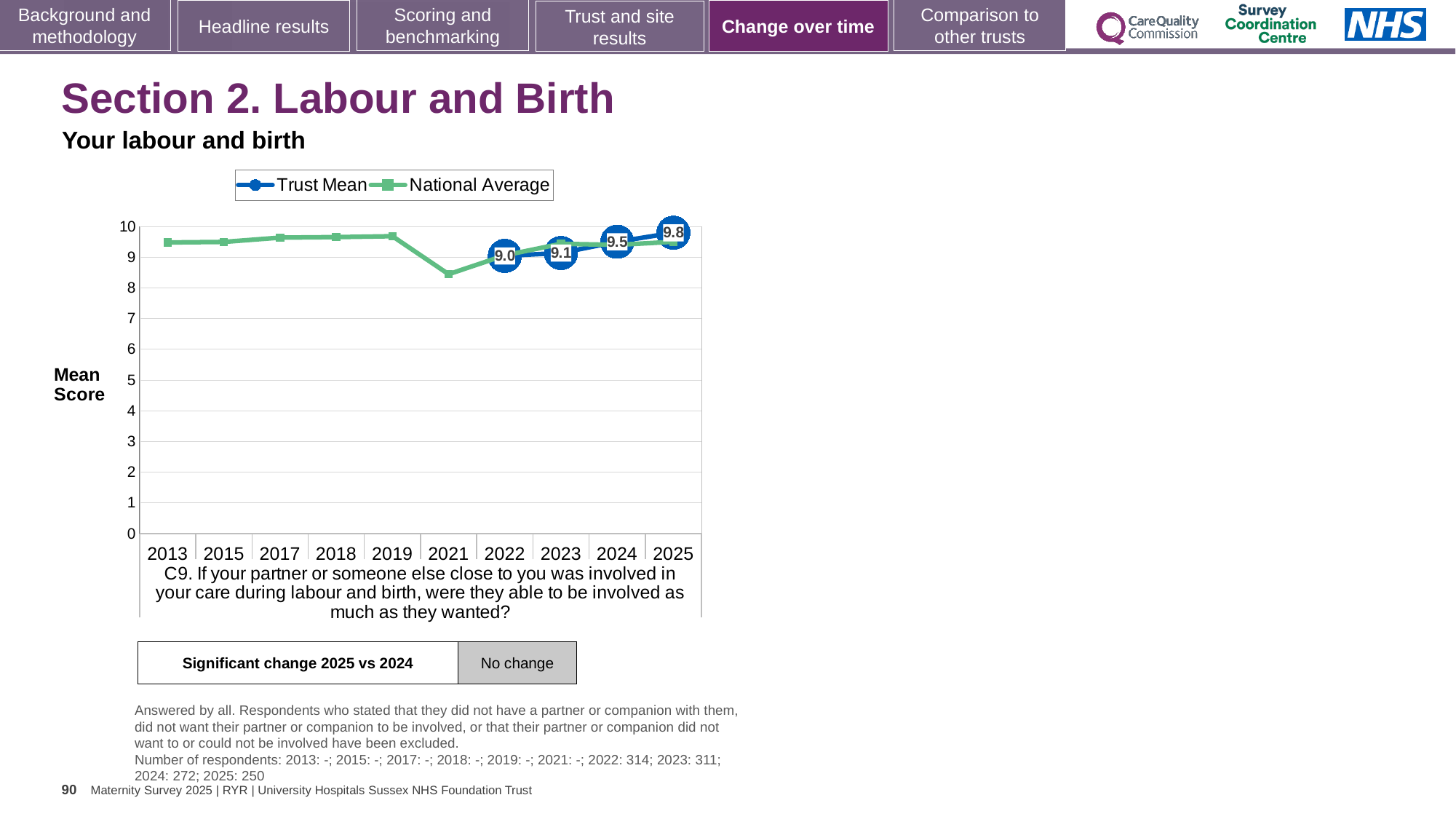
What kind of chart is shown on the slide? Line chart Does the Trust Mean score rise or fall from 2022 to 2025? Rise Is the National Average value for 2021 greater or less than 9? less What is the Trust Mean score for 2023? 9.1 What is the Trust Mean score for 2025? 9.8 How many series does the legend list? 2 In which year is the Trust Mean score lowest? 2022 What is the difference between the Trust Mean scores for 2025 and 2022? 0.8 What is the Trust Mean score for 2022? 9.0 Which year has the larger Trust Mean score, 2023 or 2024? 2024 How many years are shown on the x axis? 10 In which year is the Trust Mean score highest? 2025